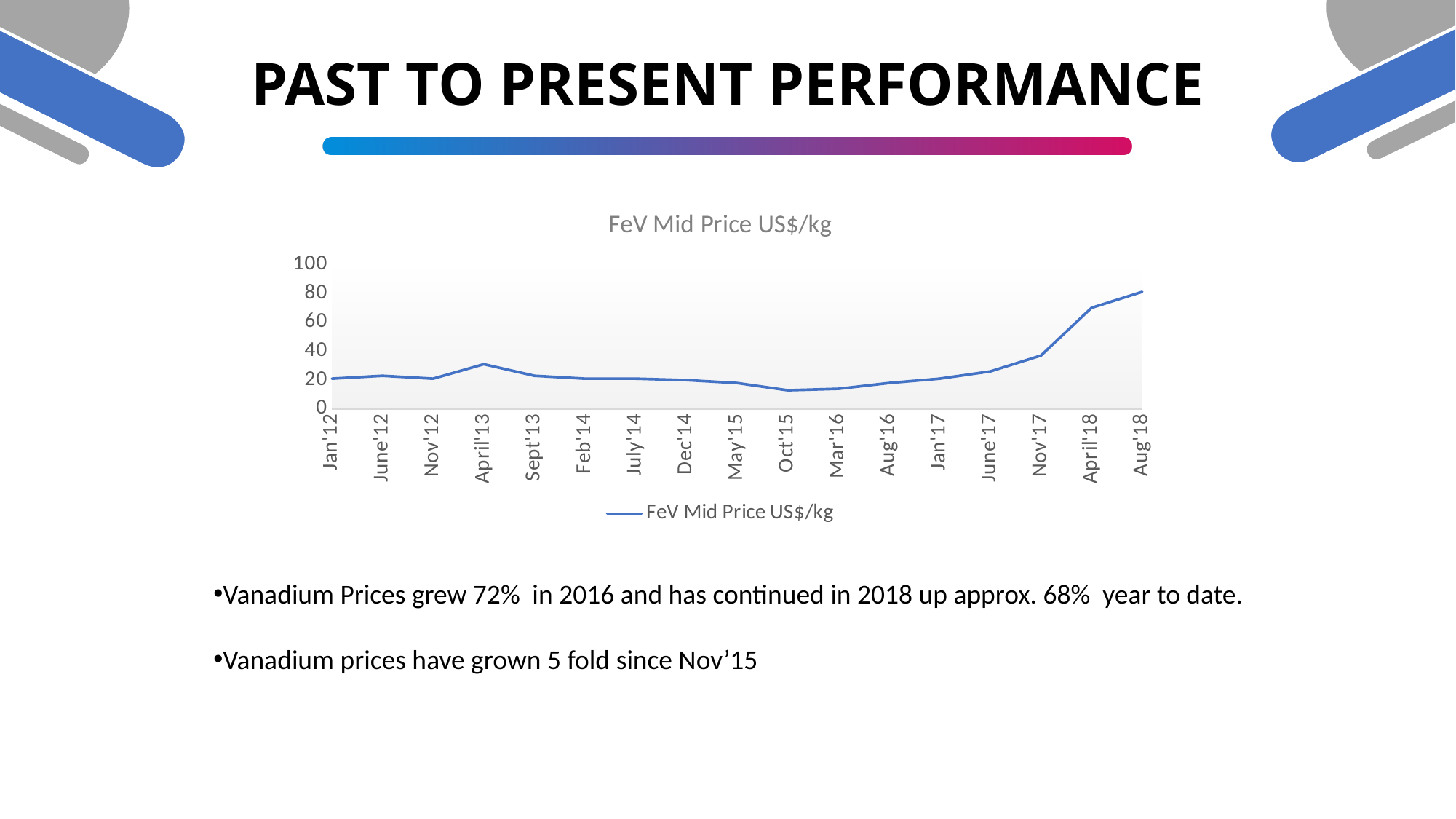
Is the FeV Mid Price at Aug'18 greater or less than 60? greater Which is larger, the FeV Mid Price at Jan'12 or at Aug'18? Aug'18 What is the title of the chart? FeV Mid Price US$/kg How many points are labelled along the x axis of the chart? 17 Is the FeV Mid Price at Oct'15 greater or less than 20? less Does the FeV Mid Price rise or fall between April'13 and Oct'15? fall Is the FeV Mid Price at April'18 greater or less than 60? greater How many series does the chart legend list? 1 What kind of chart is shown on the slide? line chart At which x-axis label does the FeV Mid Price reach its highest value? Aug'18 Does the FeV Mid Price rise or fall between Nov'17 and Aug'18? rise